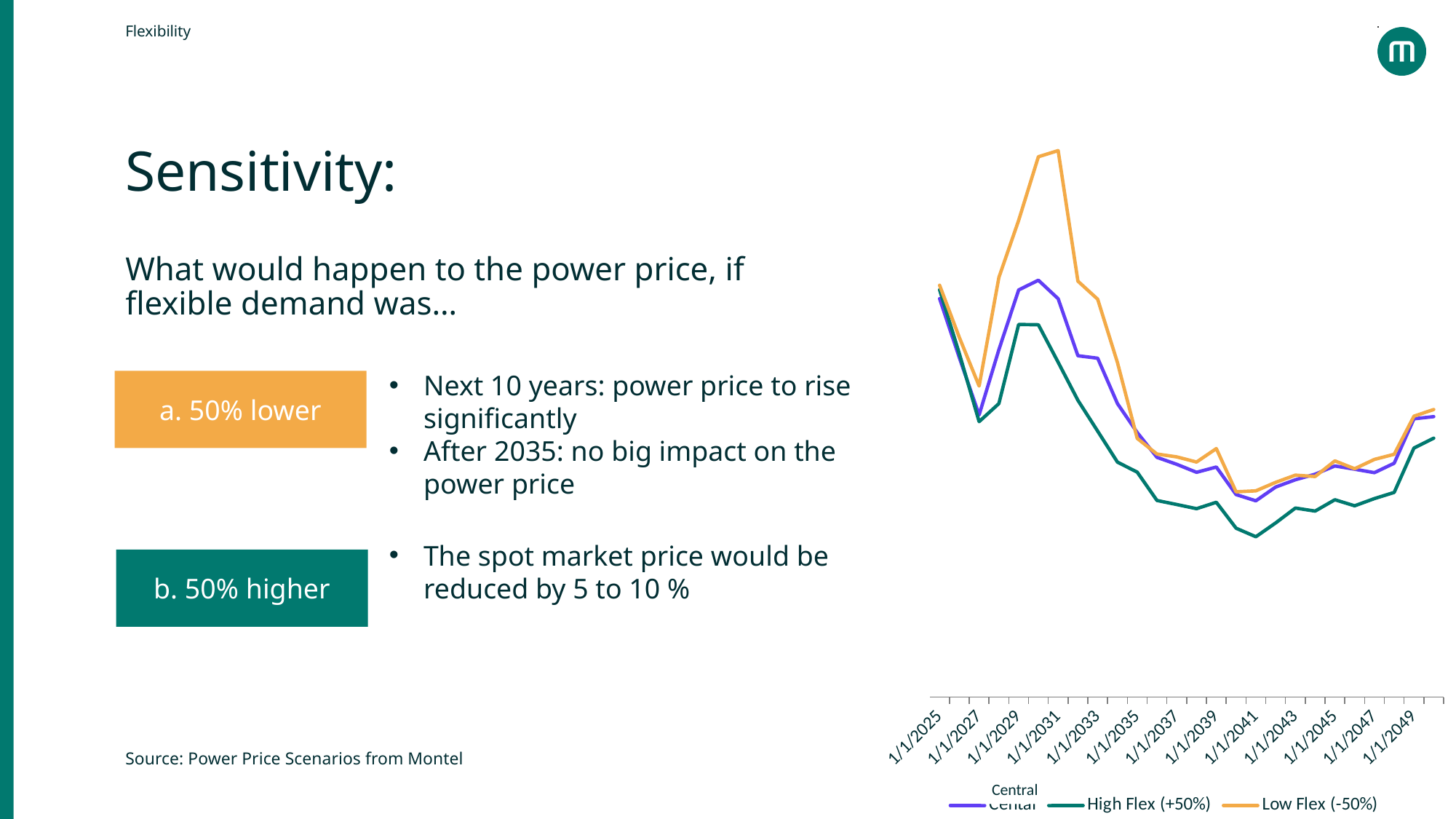
What is the first date label on the x axis of the chart? 1/1/2025 Around 1/1/2031, which series is higher: Low Flex (-50%) or Central? Low Flex (-50%) Around 1/1/2031, which series is higher: Central or High Flex (+50%)? Central Which series is shown in dark green in the chart? High Flex (+50%) Which series has the lowest values in the chart after 2035? High Flex (+50%) What kind of chart is shown on the slide? line chart Which series reaches the highest peak in the chart? Low Flex (-50%) Do the values of the Low Flex (-50%) series rise or fall between 1/1/2027 and 1/1/2031? rise How many date labels are shown on the x axis of the chart? 13 Which series is shown in orange in the chart? Low Flex (-50%) Do the values of the Central series rise or fall between 1/1/2031 and 1/1/2041? fall How many series does the chart's legend list? 3